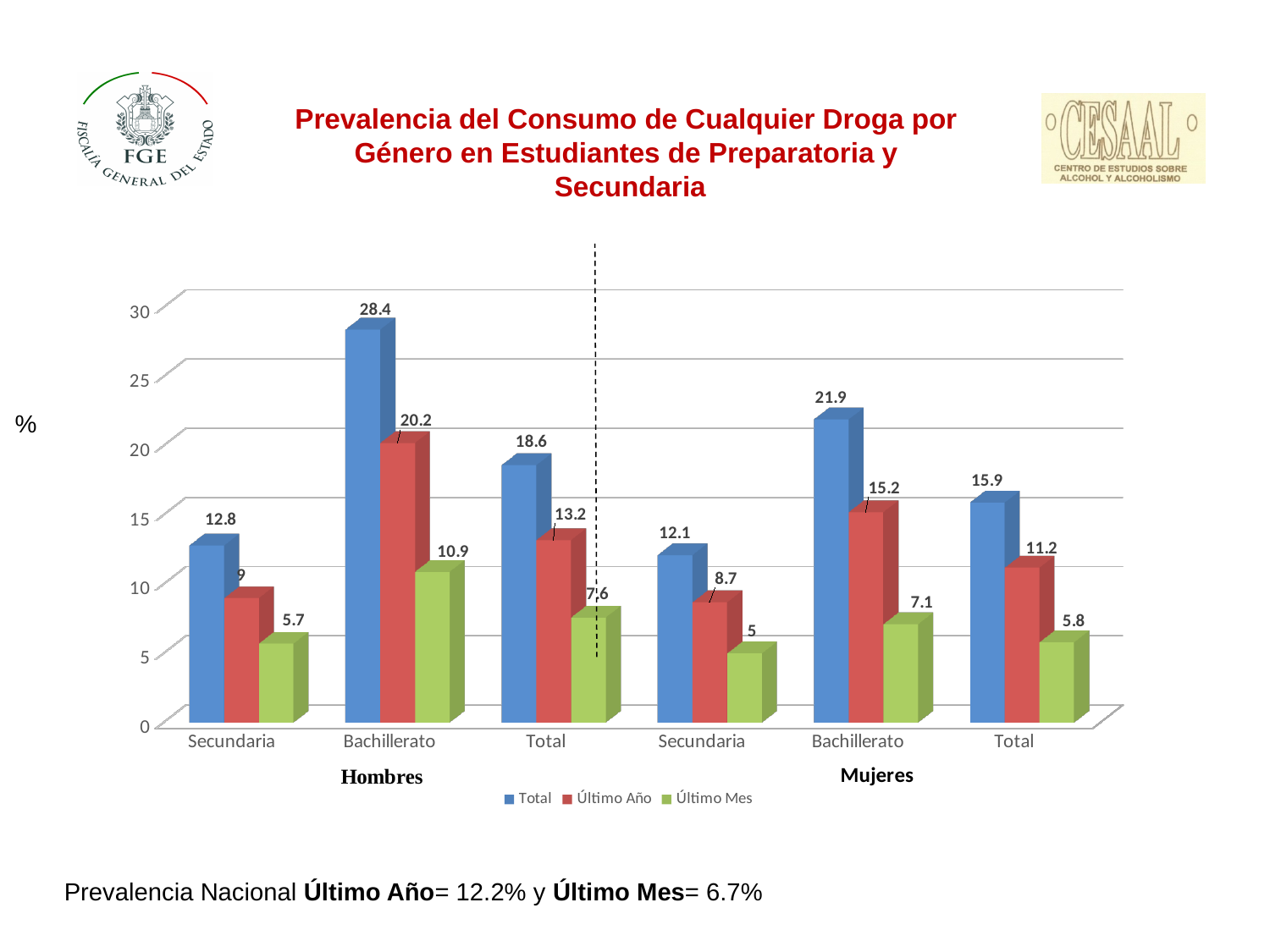
What is the Último Mes value for Secundaria among Mujeres? 5 How many series does the legend list? 3 Which category has the highest Total value? Bachillerato (Hombres) Which category has the lowest Último Mes value? Secundaria (Mujeres) Which is larger: the Último Año value for Total among Hombres or the Último Año value for Total among Mujeres? Total among Hombres (13.2) What colour represents the Último Mes series? Green What is the Último Año value for Bachillerato among Mujeres? 15.2 What is the difference between the Total value for Bachillerato among Hombres and the Total value for Bachillerato among Mujeres? 6.5 What is the Total value for Total among Mujeres? 15.9 What kind of chart is shown on the slide? Bar chart How many categories are shown on the x axis? 6 What is the Total value for Bachillerato among Hombres? 28.4